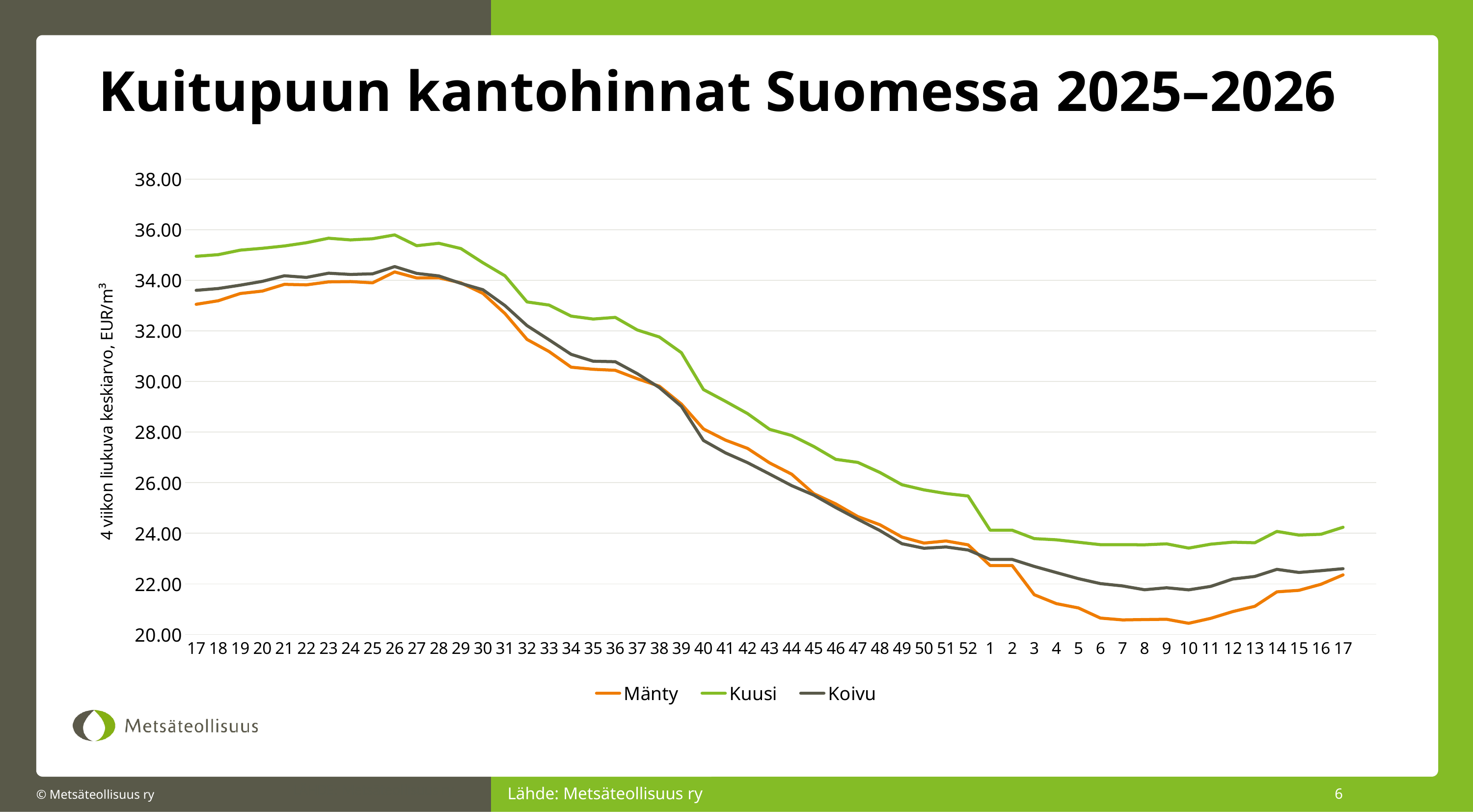
How many series does the legend list? 3 Does the Mänty series rise or fall from week 30 to week 10? Fall Which series has the highest values across the whole chart? Kuusi Which series has the lowest value at week 10? Mänty What is the title of the chart on the slide? Kuitupuun kantohinnat Suomessa 2025–2026 Which series are listed in the legend? Mänty, Kuusi, Koivu Is the value for Kuusi at week 26 greater or less than 34.00? greater Is the value for Kuusi at week 3 greater or less than 26.00? less What kind of chart is shown on the slide? Line chart At week 10, which is higher, Kuusi or Mänty? Kuusi Is the value for Mänty at week 10 greater or less than 22.00? less How many week labels are shown along the x axis? 53